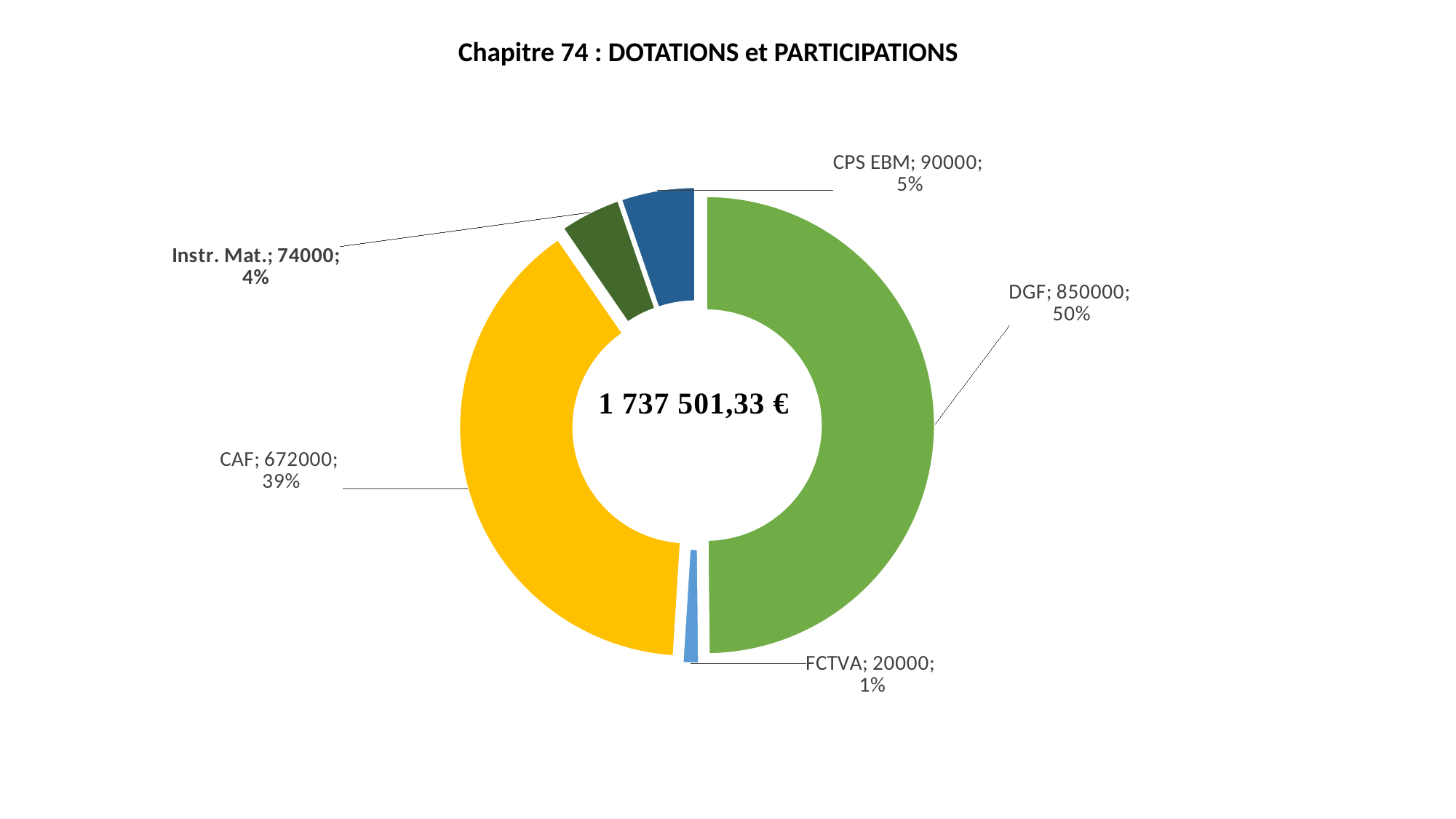
What is the value for DGF? 850000 Which is larger, the value for CPS EBM or the value for Instr. Mat.? CPS EBM What is the difference between the values for DGF and CAF? 178000 What is the title of the chart? Chapitre 74 : DOTATIONS et PARTICIPATIONS What is the value for FCTVA? 20000 What is the value for CPS EBM? 90000 What is the value for CAF? 672000 What share of the chart does CAF represent? 39% Which category has the smallest slice? FCTVA What is the value for Instr. Mat.? 74000 Which category has the largest slice? DGF How many categories are shown in the chart? 5